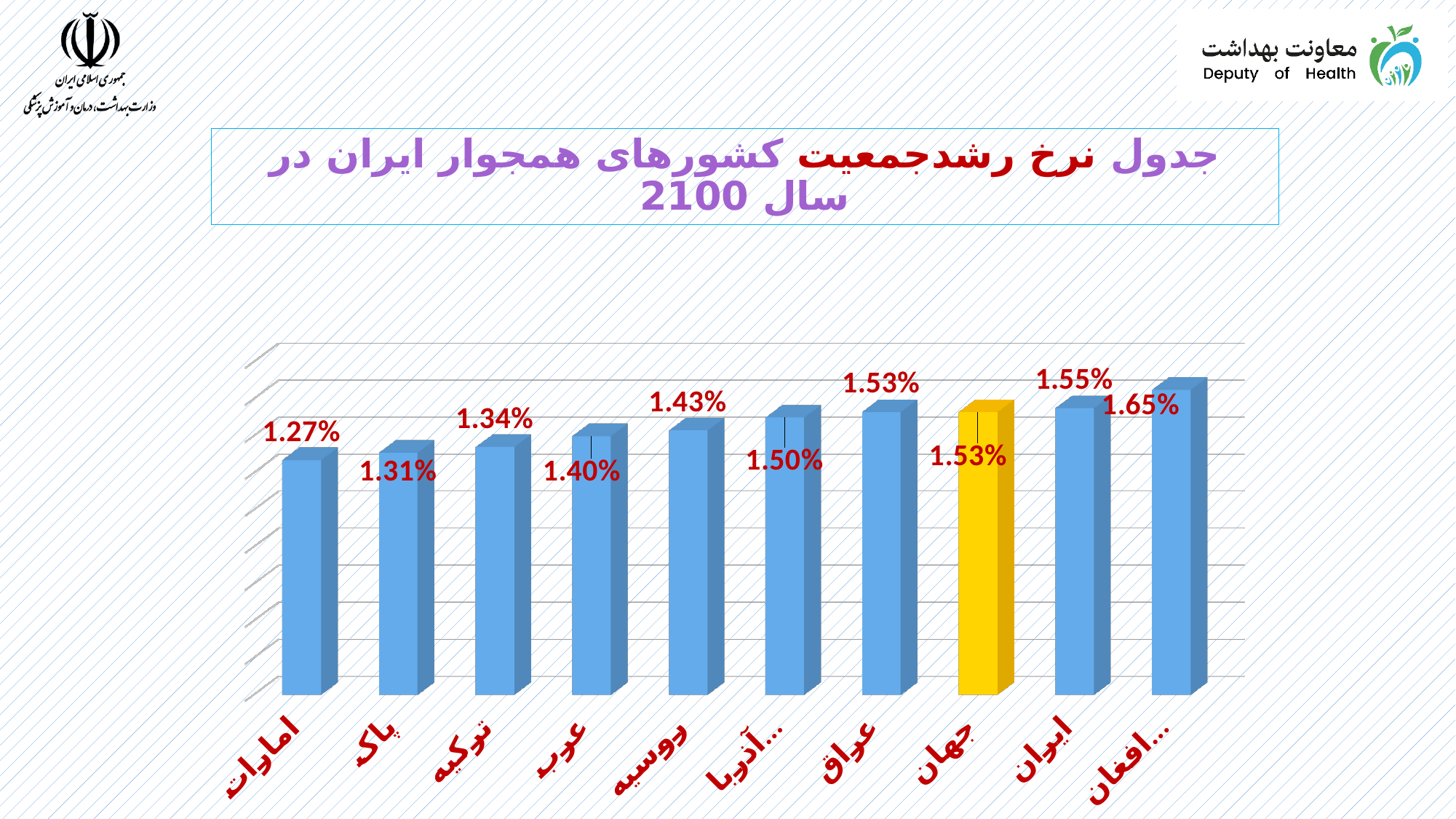
Which category has the highest value? افغان... What is the value shown for امارات? 1.27% What kind of chart is shown on the slide? bar chart Which is larger, the value for ایران or the value for عراق? ایران What is the difference between the values for عرب and ترکیه? 0.06% How many categories are shown on the chart? 10 What is the value shown for the yellow bar labelled جهان? 1.53% What is the difference between the values for ایران and امارات? 0.28% Which category has the lowest value? امارات What is the value shown for روسیه? 1.43% Which bar is coloured differently (yellow) from the others? جهان What is the value shown for ایران? 1.55%